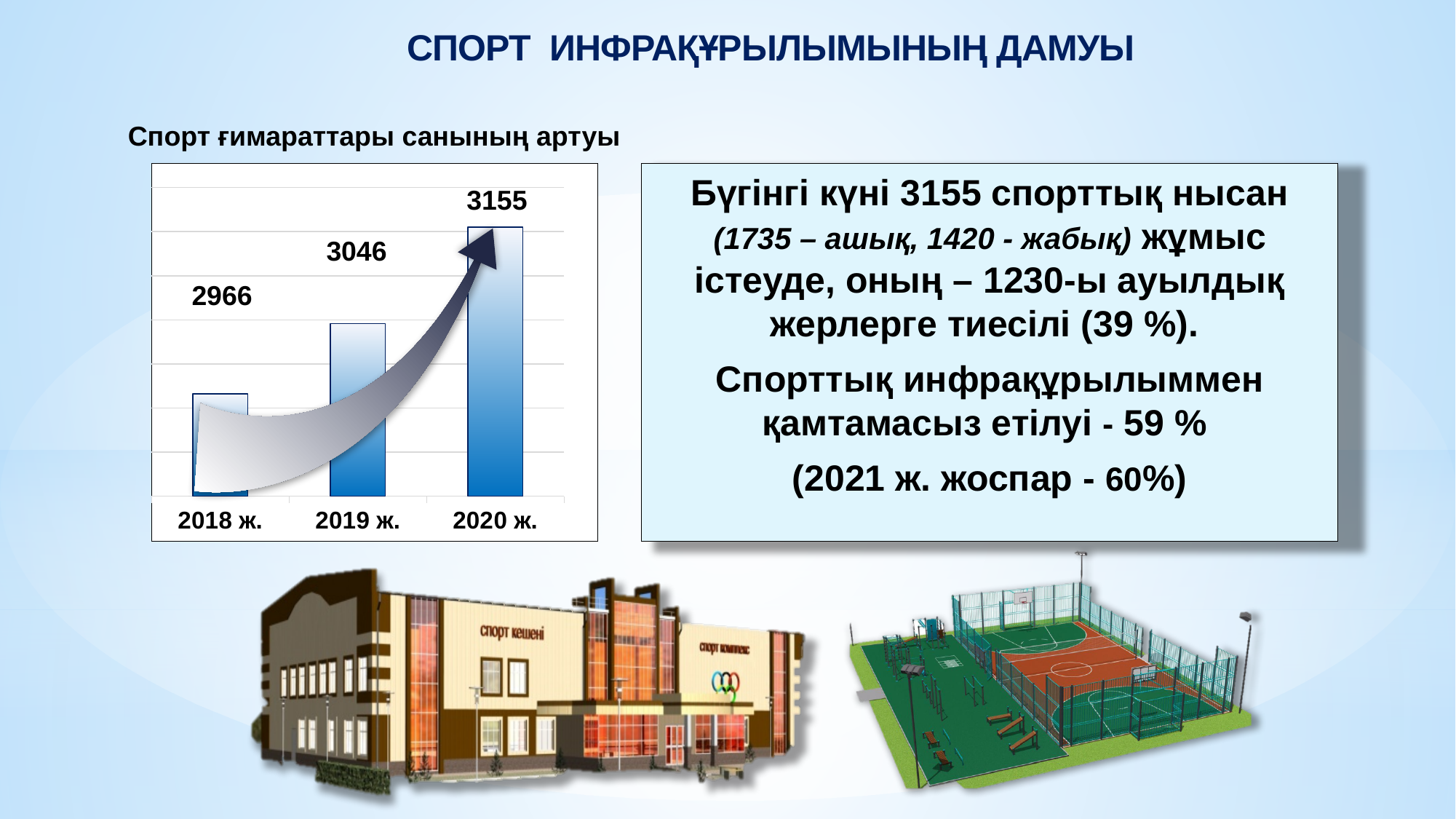
What is the value for 2020 ж. in the chart? 3155 What kind of chart is shown on the slide? bar chart Do the values rise or fall from 2018 ж. to 2020 ж.? rise How many categories are shown on the x axis of the chart? 3 Which is larger, the value for 2019 ж. or the value for 2018 ж.? 2019 ж. What is the difference between the values for 2020 ж. and 2019 ж.? 109 What is the title of the chart? Спорт ғимараттары санының артуы Which year has the lowest value in the chart? 2018 ж. What is the value for 2018 ж. in the chart? 2966 Which year has the highest value in the chart? 2020 ж. What is the difference between the values for 2019 ж. and 2018 ж.? 80 What is the value for 2019 ж. in the chart? 3046